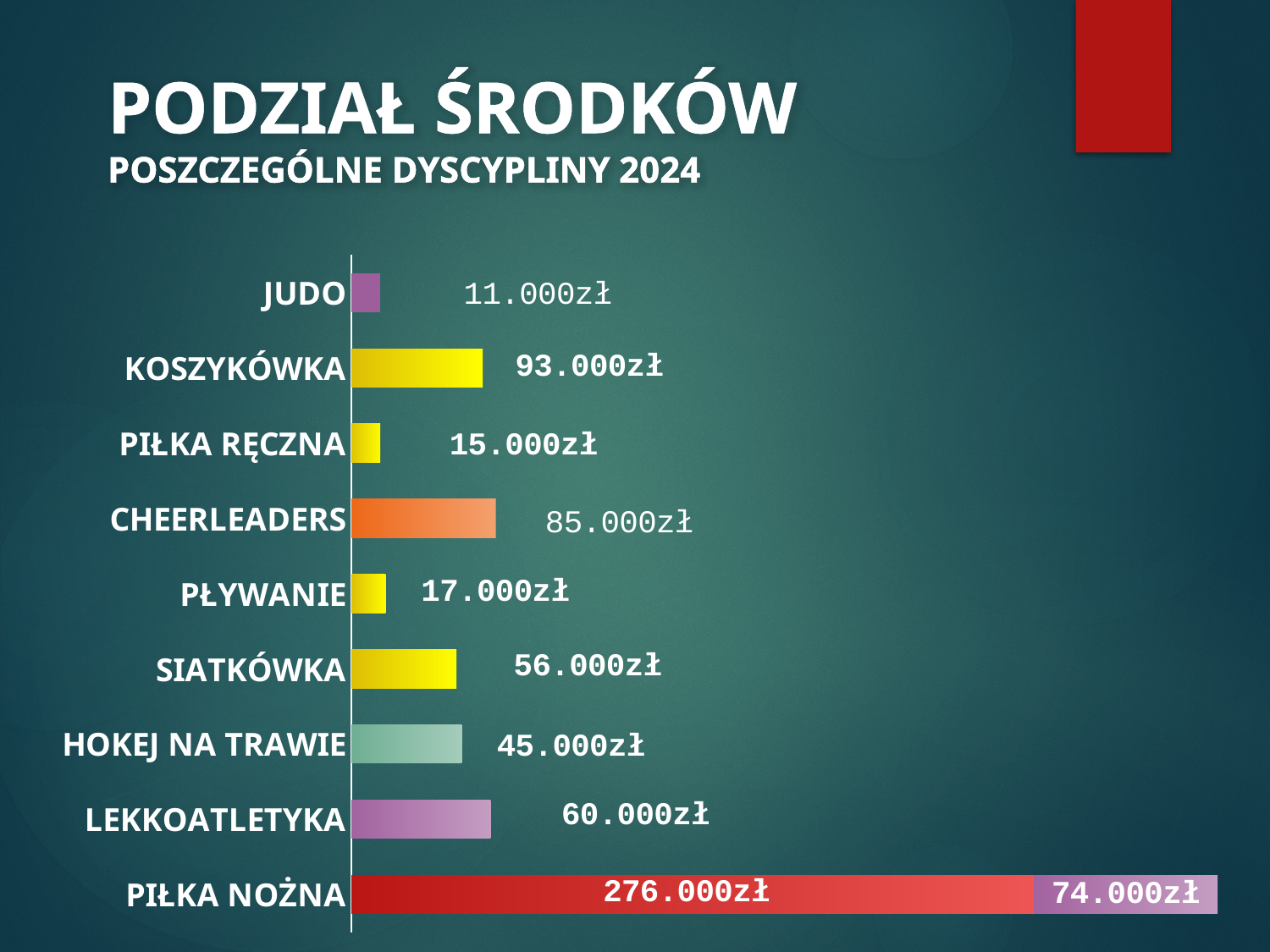
How many disciplines (categories) are shown in the chart? 9 What is the total of the stacked PIŁKA NOŻNA bar (276.000zł + 74.000zł)? 350.000zł What kind of chart is shown on the slide? bar chart Which discipline has the lowest value? JUDO What is the value shown for JUDO? 11.000zł Which discipline has the highest value? PIŁKA NOŻNA What is the value of the first (red) segment of the PIŁKA NOŻNA bar? 276.000zł What is the difference between the values for KOSZYKÓWKA and CHEERLEADERS? 8.000zł What is the value shown for HOKEJ NA TRAWIE? 45.000zł Which has a larger value, SIATKÓWKA or LEKKOATLETYKA? LEKKOATLETYKA What is the value shown for KOSZYKÓWKA? 93.000zł What is the subtitle of the chart shown under the main title? POSZCZEGÓLNE DYSCYPLINY 2024